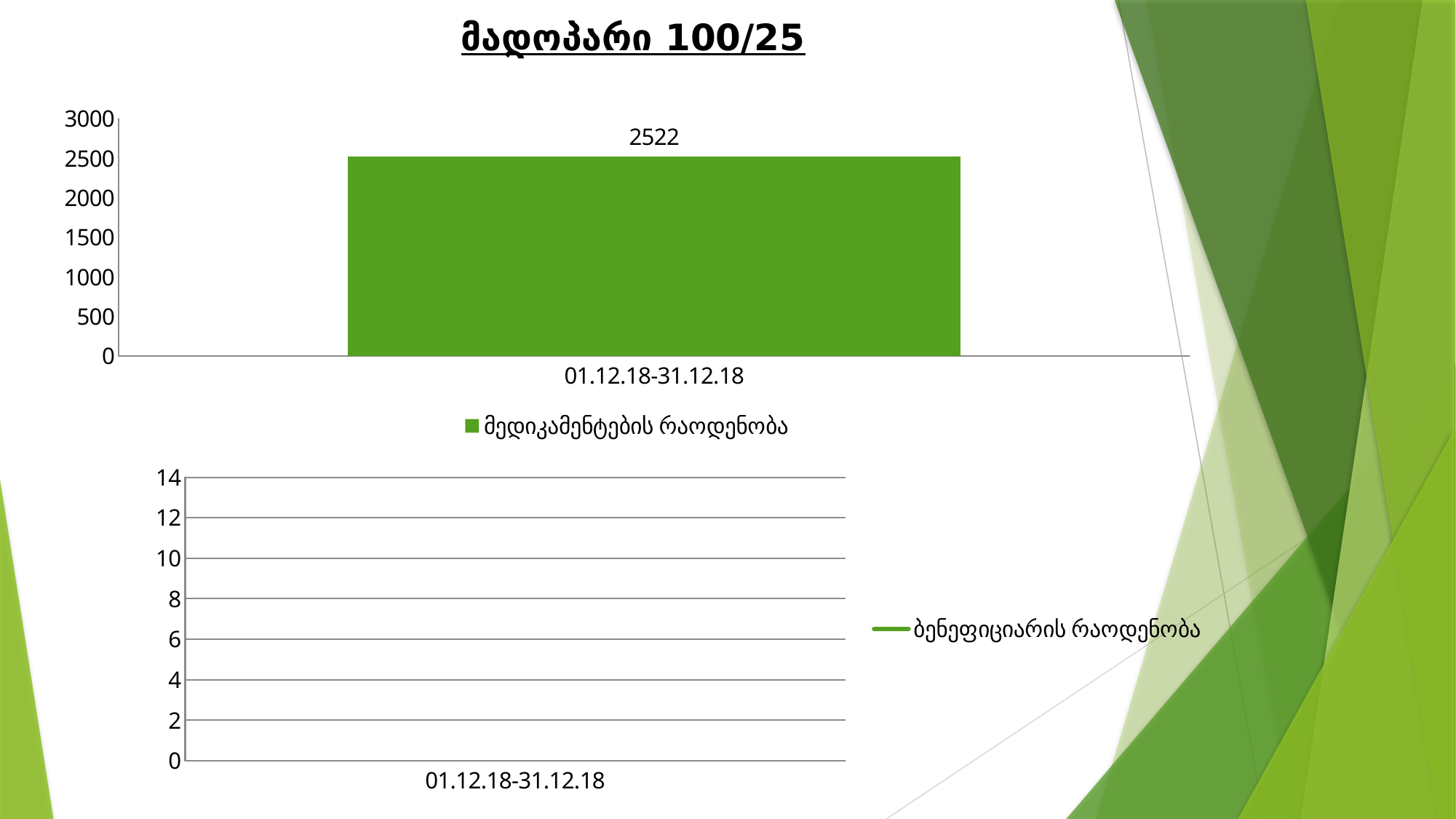
What is the highest value shown on the y axis of the bottom chart? 14 How many categories are shown on the x axis of the bottom chart? 1 What is the legend entry of the top chart? მედიკამენტების რაოდენობა What kind of chart is the bottom chart, according to its legend marker? line chart In the top chart, what is the value of the bar for 01.12.18-31.12.18? 2522 How many bars are plotted in the top chart? 1 What is the category label on the x axis of the top chart? 01.12.18-31.12.18 What kind of chart is the top chart? bar chart In the top chart, is the value for 01.12.18-31.12.18 greater or less than 2500? greater How many series does the legend of the bottom chart list? 1 How many series does the legend of the top chart list? 1 In the top chart, is the value for 01.12.18-31.12.18 greater or less than 3000? less